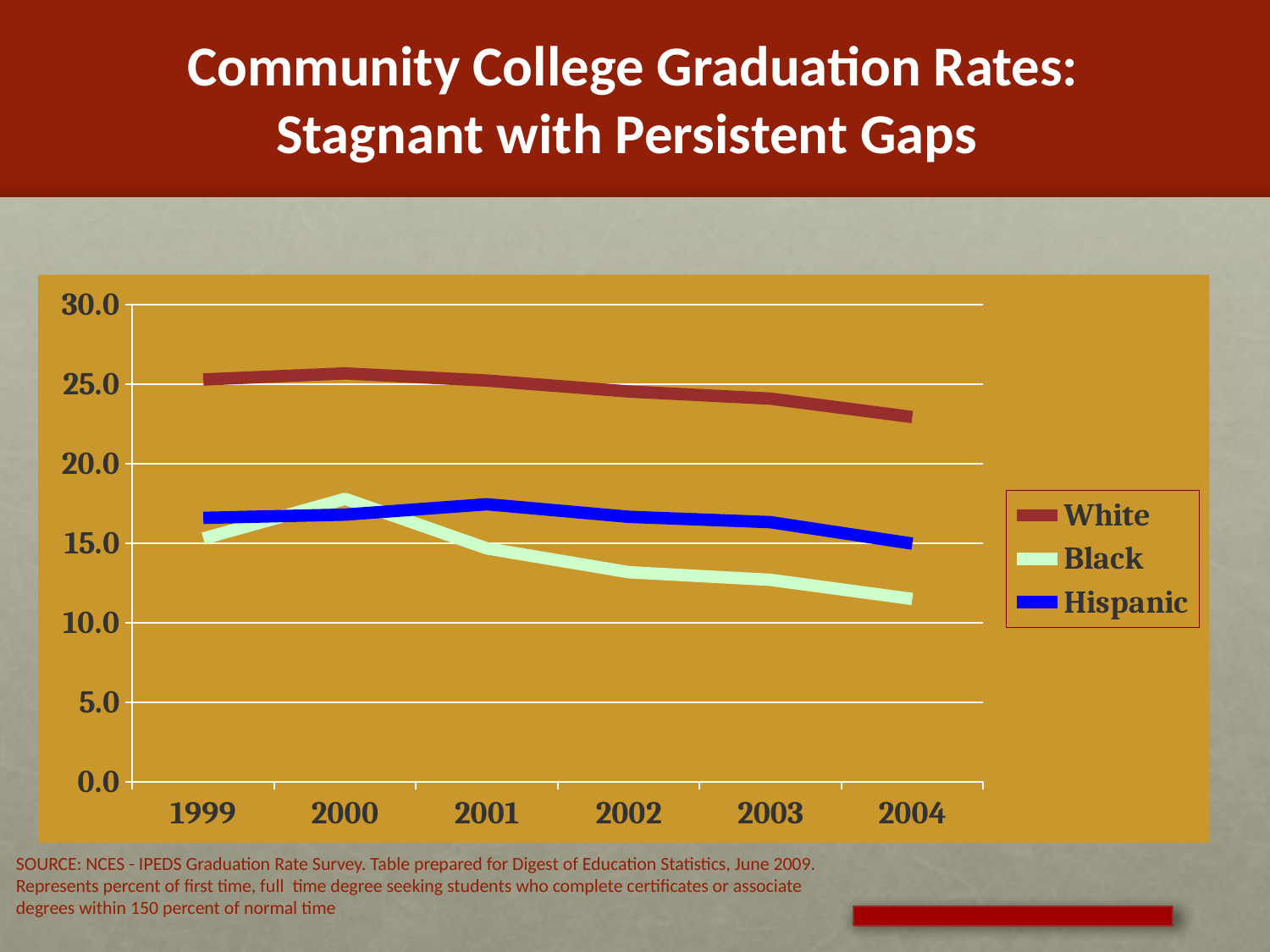
Is the value for Hispanic in 2001 greater or less than 15.0? greater Does the White line rise or fall from 2000 to 2004? fall Which series has the lowest value in 2004? Black Which is larger in 2003, the value for Black or the value for Hispanic? Hispanic How many series does the legend list? 3 Is the value for White in 2004 greater or less than 25.0? less Is the value for Black in 2000 greater or less than 15.0? greater How many years are shown along the x axis? 6 Which series has the highest value in 2004? White What colour is the Hispanic line in the legend? blue What kind of chart is shown on the slide? line chart